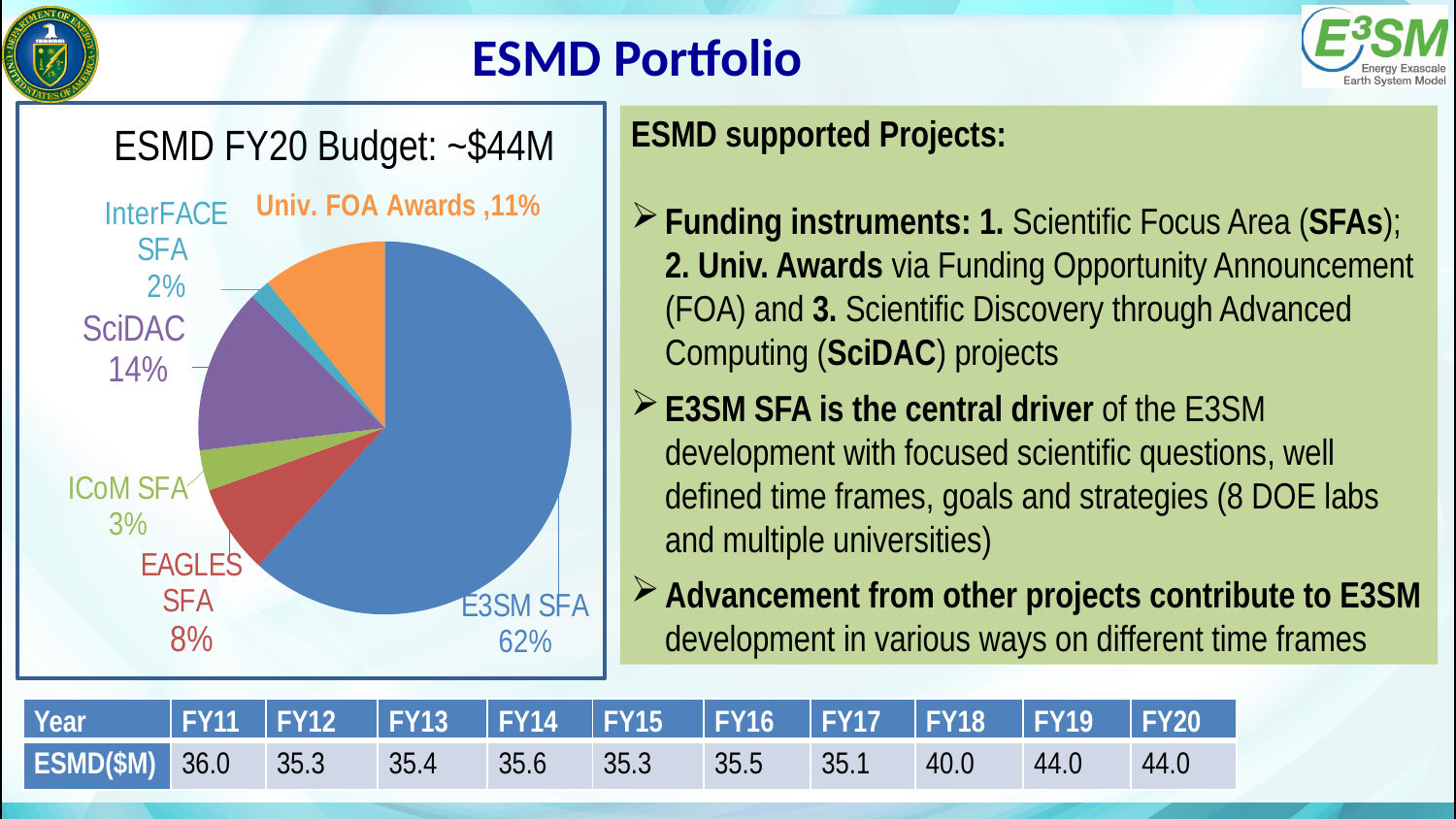
What percentage of the pie chart is labelled SciDAC? 14% What percentage is shown for InterFACE SFA in the pie chart? 2% Which slice of the ESMD FY20 Budget pie chart is the largest? E3SM SFA What share of the ESMD FY20 budget pie chart goes to E3SM SFA? 62% What share does Univ. FOA Awards have in the ESMD FY20 Budget pie chart? 11% Which is larger in the pie chart, SciDAC or EAGLES SFA? SciDAC Which slice of the ESMD FY20 Budget pie chart is the smallest? InterFACE SFA What is the difference in percentage points between the E3SM SFA slice and the SciDAC slice? 48 What type of chart is used to show the ESMD FY20 Budget? Pie chart How many slices does the ESMD FY20 Budget pie chart have? 6 What is the title of the pie chart? ESMD FY20 Budget: ~$44M What percentage is shown for EAGLES SFA in the pie chart? 8%